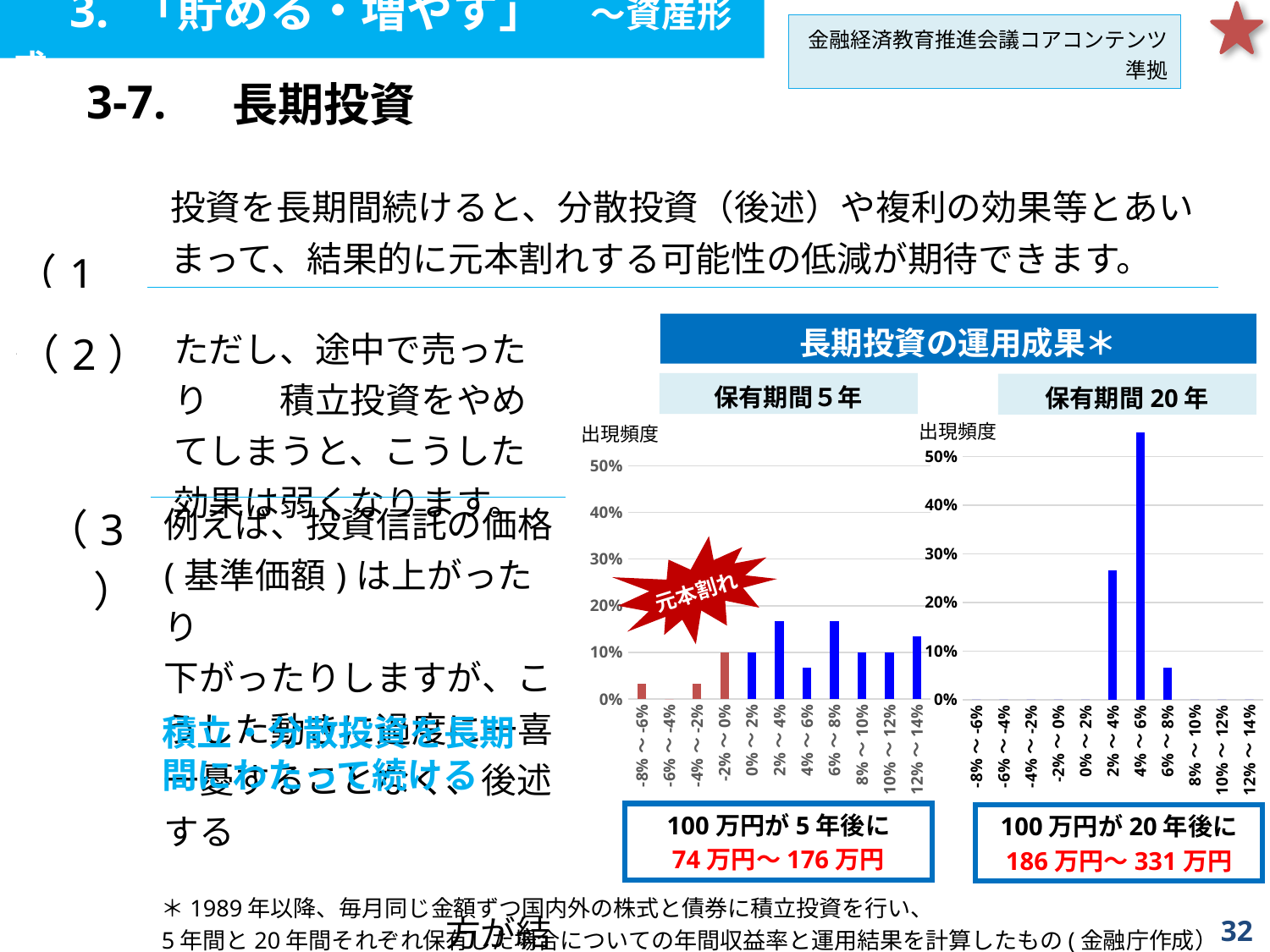
In the 保有期間20年 chart, is the value for 6%～8% greater or less than 10%? less How many return-range categories are shown on the x axis of the 保有期間20年 chart? 11 What is the title shown above the two charts? 長期投資の運用成果＊ In the 保有期間5年 chart, which is larger, the value for 2%～4% or the value for 4%～6%? 2%～4% What kind of chart is the 保有期間5年 chart? bar chart What label is shown on the vertical axis of the 保有期間5年 chart? 出現頻度 In the 保有期間5年 chart, is the value for -8%～-6% greater or less than 10%? less In the 保有期間20年 chart, which is larger, the value for 2%～4% or the value for 6%～8%? 2%～4% In the 保有期間20年 chart, is the value for 2%～4% greater or less than 20%? greater In the 保有期間20年 chart, which category has the highest frequency? 4%～6%